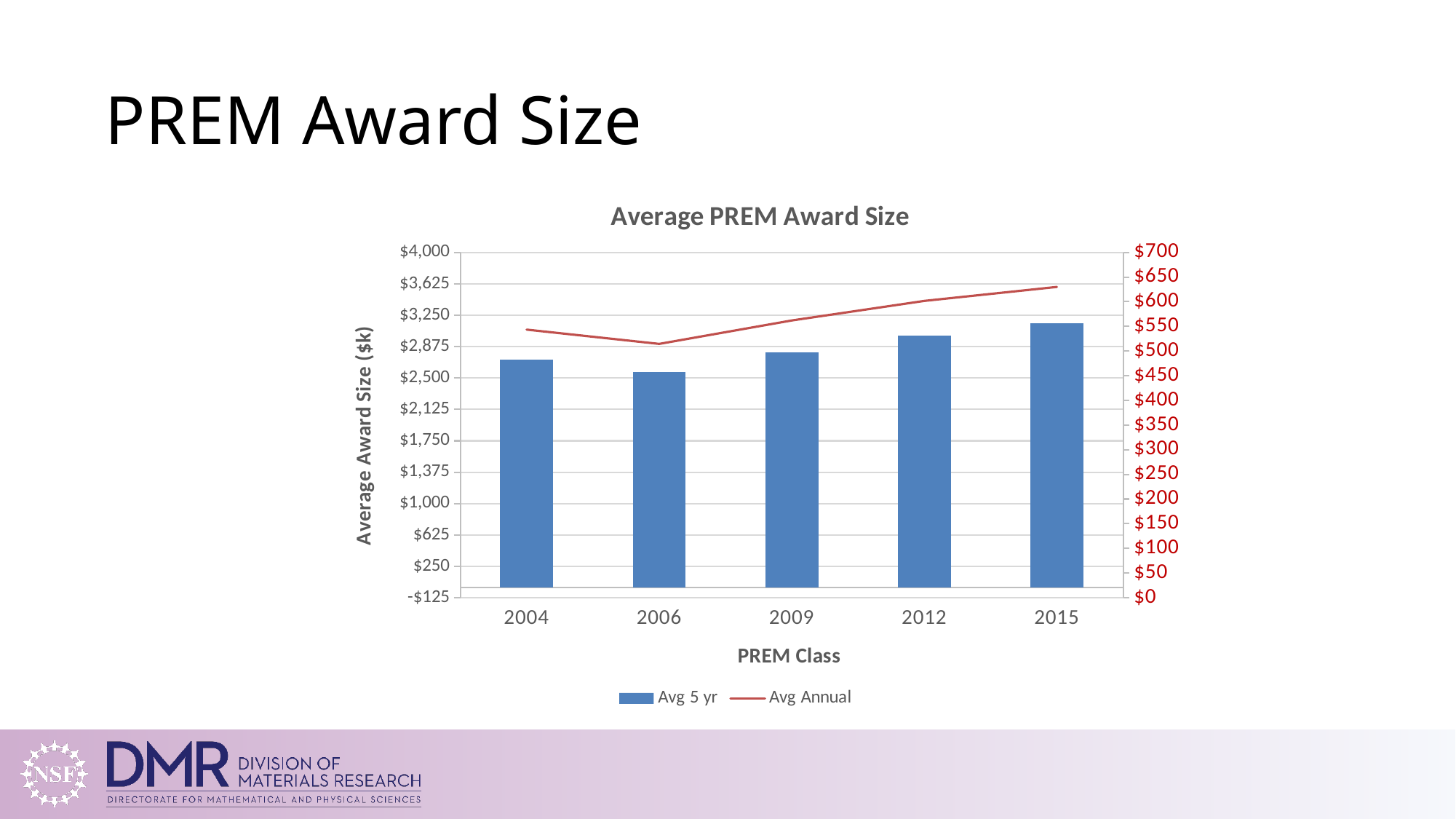
What is the title of the chart? Average PREM Award Size Which PREM class has the highest Avg 5 yr bar? 2015 What kind of chart is shown on the slide? A bar chart combined with a line Which PREM class has the highest point on the Avg Annual line? 2015 Which has the larger Avg 5 yr bar, 2012 or 2006? 2012 Is the Avg 5 yr value for 2015 greater or less than $2,875? greater Which PREM class has the lowest point on the Avg Annual line? 2006 Which PREM class has the lowest Avg 5 yr bar? 2006 Is the Avg Annual value for 2015 greater or less than $600? greater How many PREM classes are shown on the x axis? 5 Is the Avg 5 yr value for 2006 greater or less than $2,875? less How many series does the legend list? 2